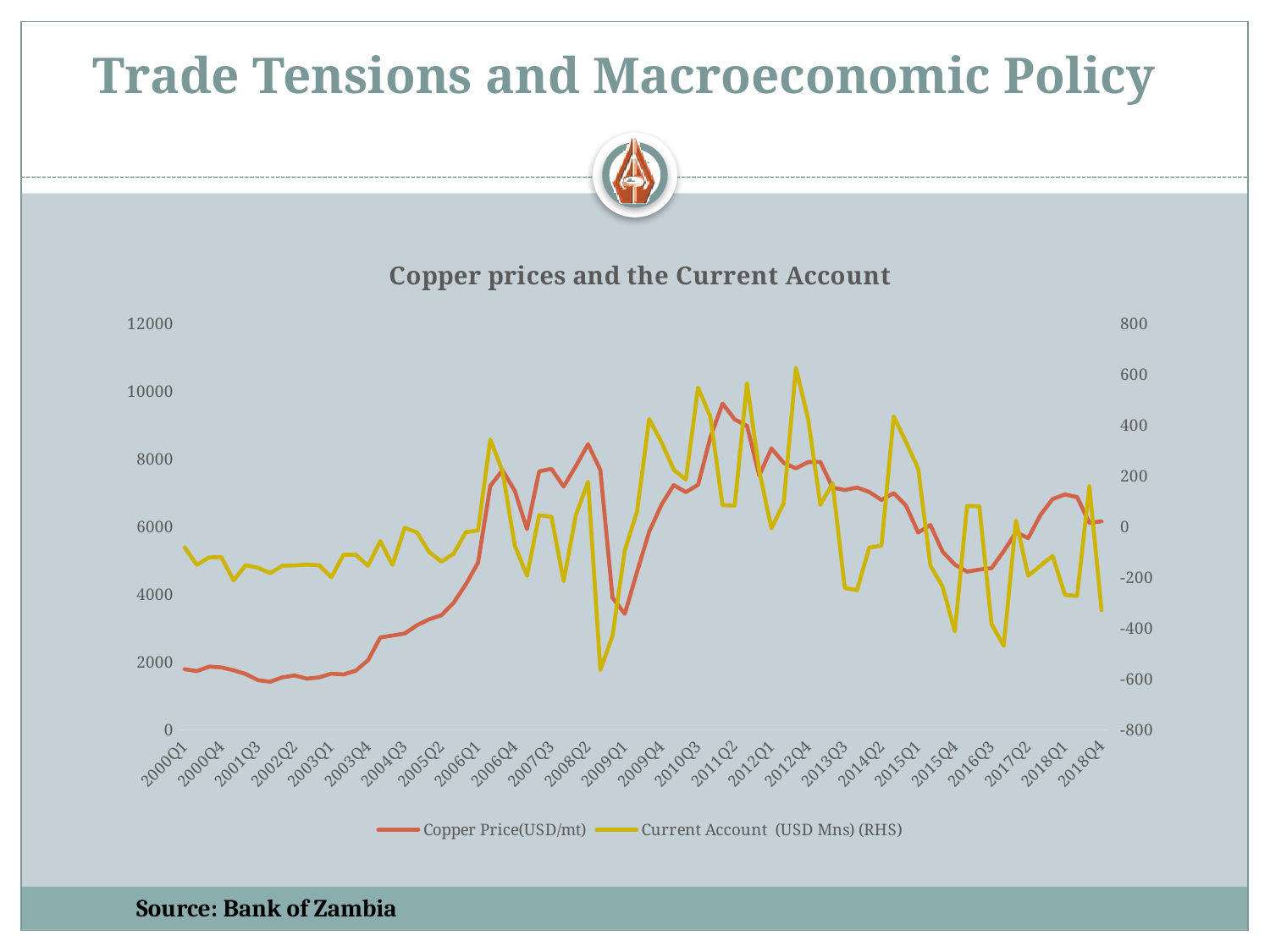
Which series is plotted on the right-hand axis (RHS)? Current Account (USD Mns) How many series does the legend list? 2 At which quarter does the Current Account reach its highest value? 2012Q3 What kind of chart is shown on the slide? line chart Is the Copper Price at 2011Q2 greater or less than 8000? greater At which quarter does the Copper Price reach its highest value? 2011Q1 Is the Copper Price at 2000Q1 greater or less than 2000? less Which is larger, the Copper Price at 2011Q2 or at 2002Q2? 2011Q2 Does the Copper Price rise or fall between 2000Q1 and 2006Q1? rise Is the Current Account at 2018Q4 greater or less than -200? less What is the title of the chart? Copper prices and the Current Account